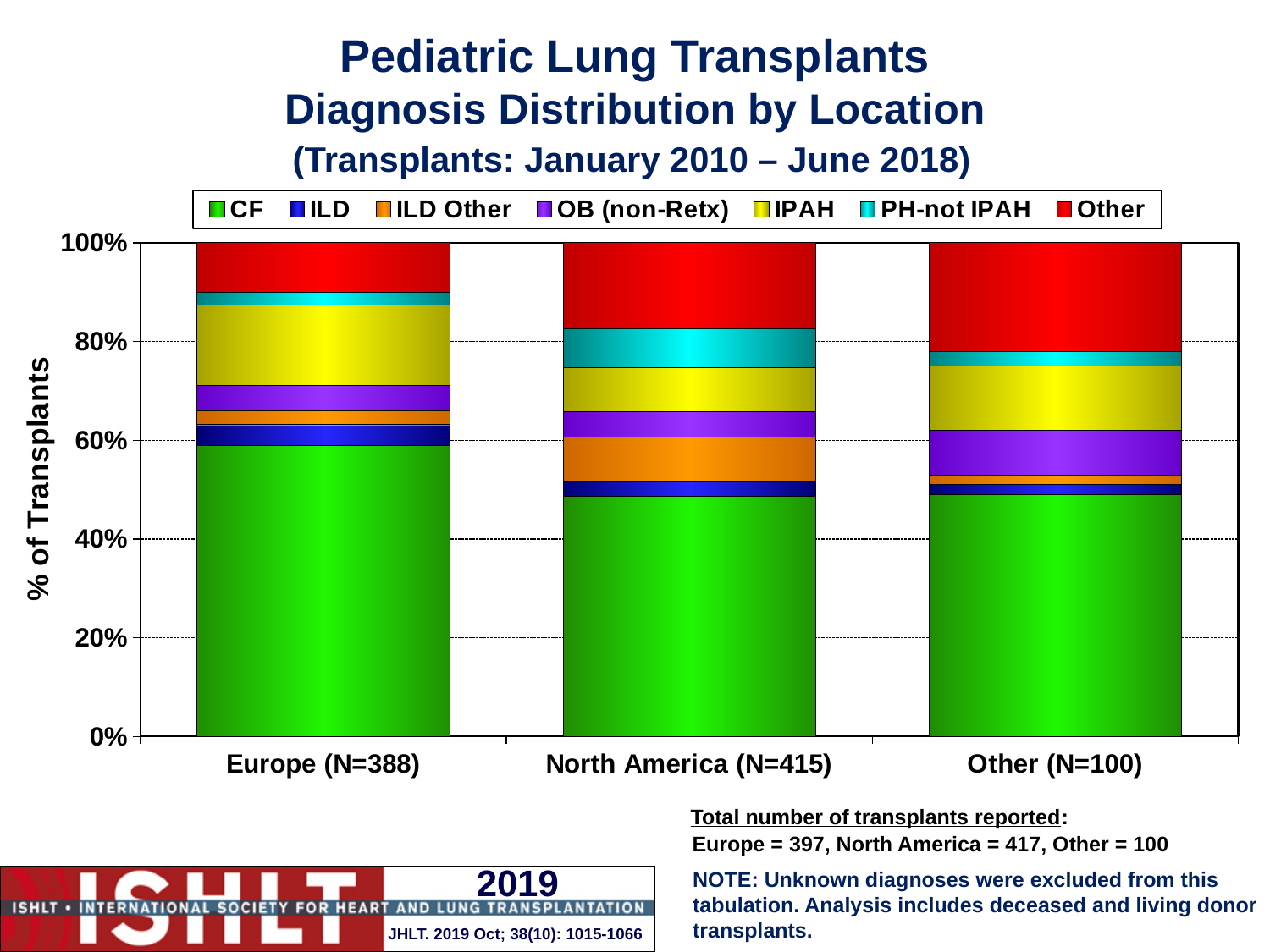
What is the N shown in the x-axis label for Europe? 388 What kind of chart is shown on the slide? Stacked bar chart Which location has the larger CF share, Europe or North America? Europe How many diagnosis series does the legend list? 7 What is the N shown in the x-axis label for North America? 415 Is the CF share for Europe greater or less than 40%? greater Which location has the largest ILD Other segment? North America (N=415) What does each stacked bar total? 100% Which diagnosis is listed first in the legend? CF How many location categories are shown on the x axis? 3 Is the CF share for North America greater or less than 60%? less Which location has the largest OB (non-Retx) segment? Other (N=100)